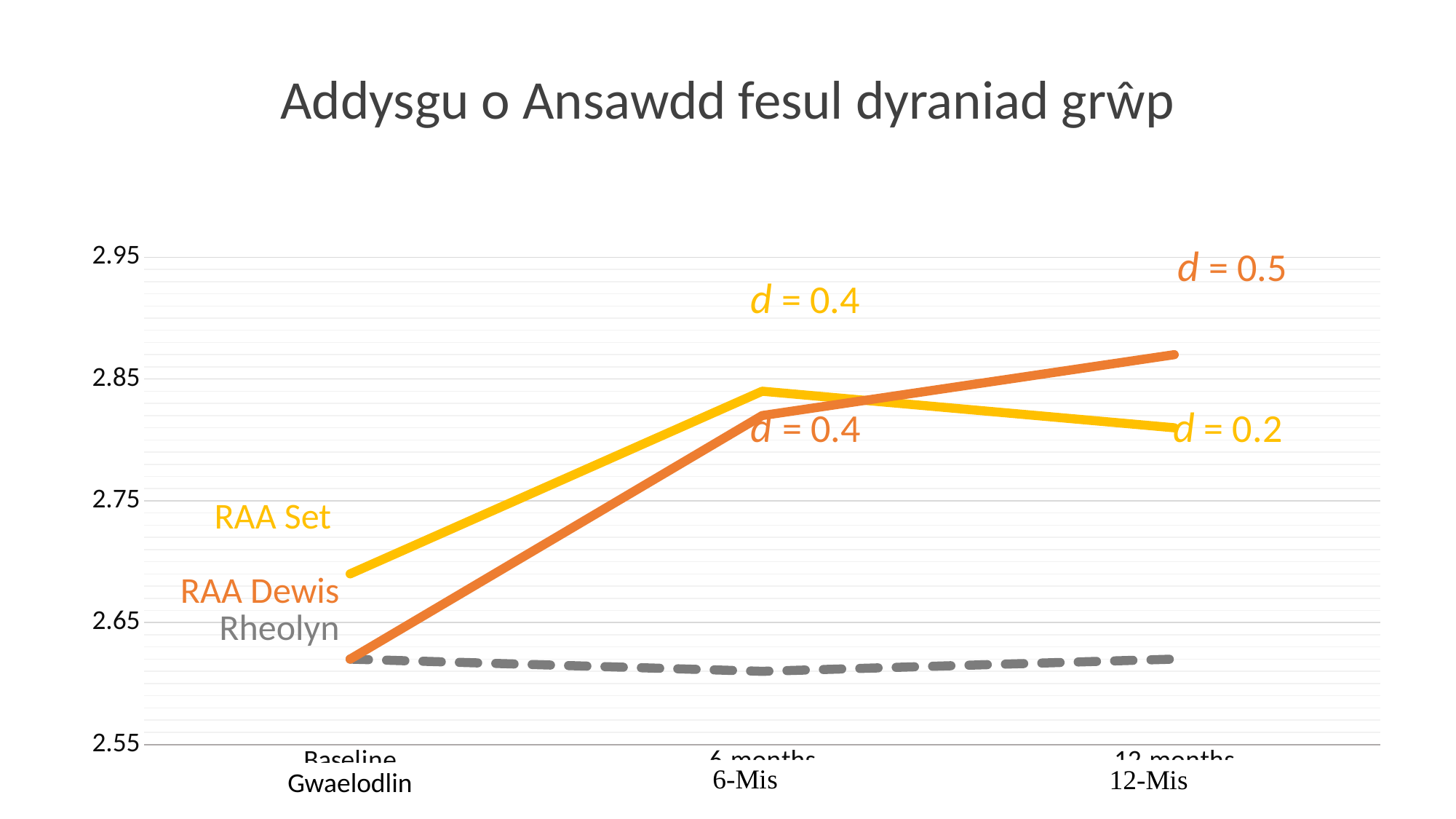
How many time points are shown on the x axis? 3 What effect size (d) is annotated for RAA Dewis at 12-Mis? d = 0.5 What is the title of the chart? Addysgu o Ansawdd fesul dyraniad grŵp Is the value for RAA Set at 6-Mis greater or less than 2.75? greater Is the value for Rheolyn at 12-Mis greater or less than 2.65? less What kind of chart is shown on the slide? line chart How many series (groups) are plotted on the chart? 3 Is the value for RAA Dewis at Gwaelodlin greater or less than 2.65? less Does the RAA Dewis line rise or fall from Gwaelodlin to 12-Mis? rise Which group has the highest value at 12-Mis? RAA Dewis At Gwaelodlin, which is higher: RAA Set or RAA Dewis? RAA Set Which group has the lowest value at 12-Mis? Rheolyn